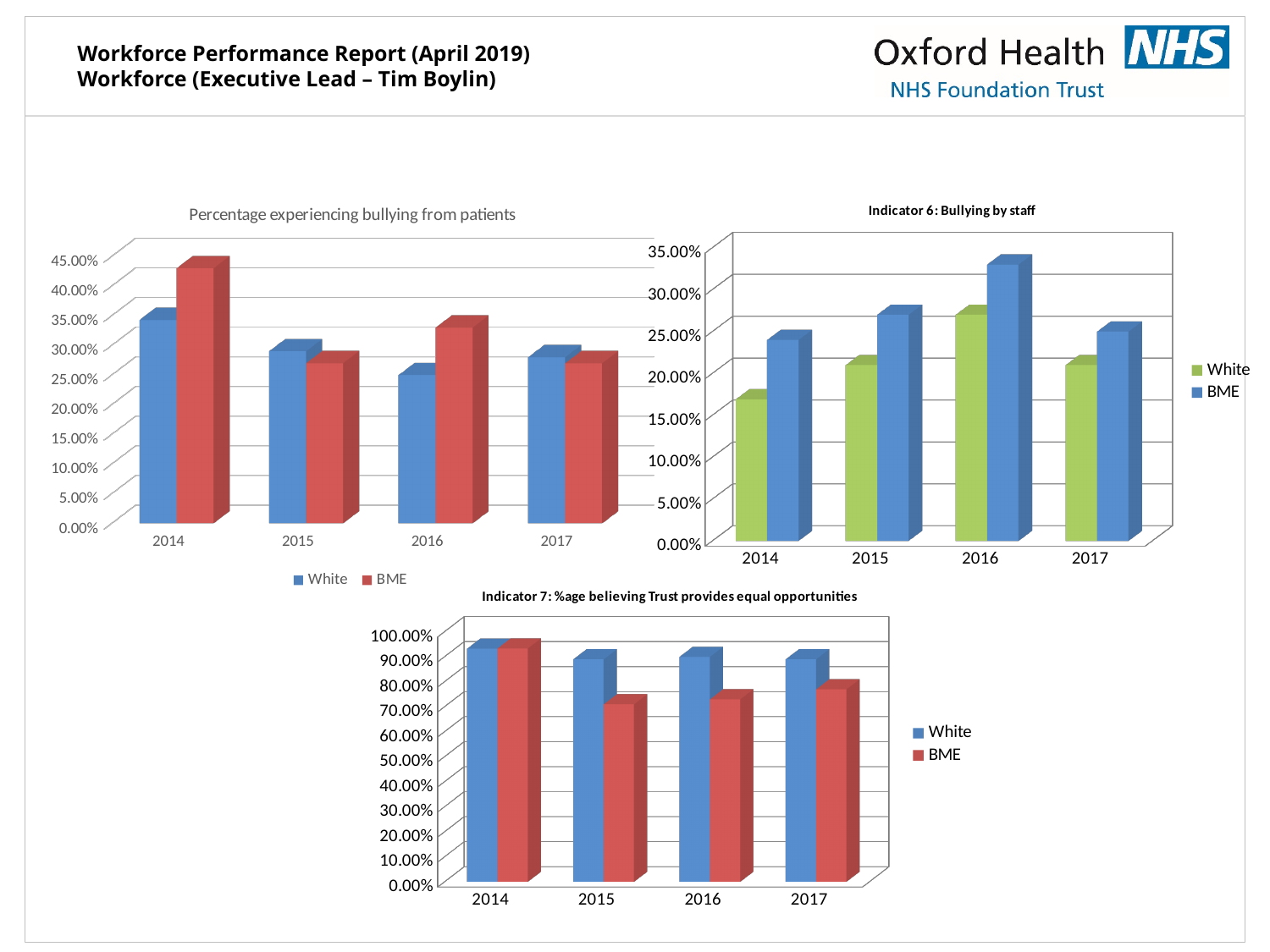
In the chart titled 'Indicator 6: Bullying by staff', do the White values rise or fall from 2014 to 2016? rise In the chart titled 'Indicator 6: Bullying by staff', which is larger in 2016, the White value or the BME value? BME In the chart titled 'Indicator 6: Bullying by staff', is the White value for 2014 greater or less than 20.00%? less In the chart titled 'Indicator 7: %age believing Trust provides equal opportunities', how many years are shown on the x axis? 4 In the chart titled 'Indicator 6: Bullying by staff', how many series does the legend list? 2 In the chart titled 'Percentage experiencing bullying from patients', is the BME value for 2014 greater or less than 40.00%? greater In the chart titled 'Percentage experiencing bullying from patients', which year has the highest BME value? 2014 In the chart titled 'Indicator 7: %age believing Trust provides equal opportunities', is the BME value for 2015 greater or less than 80.00%? less In the chart titled 'Percentage experiencing bullying from patients', which year has the lowest White value? 2016 In the chart titled 'Indicator 6: Bullying by staff', which year has the highest BME value? 2016 In the chart titled 'Percentage experiencing bullying from patients', what kind of chart is shown? bar chart In the chart titled 'Indicator 7: %age believing Trust provides equal opportunities', which year has the lowest BME value? 2015